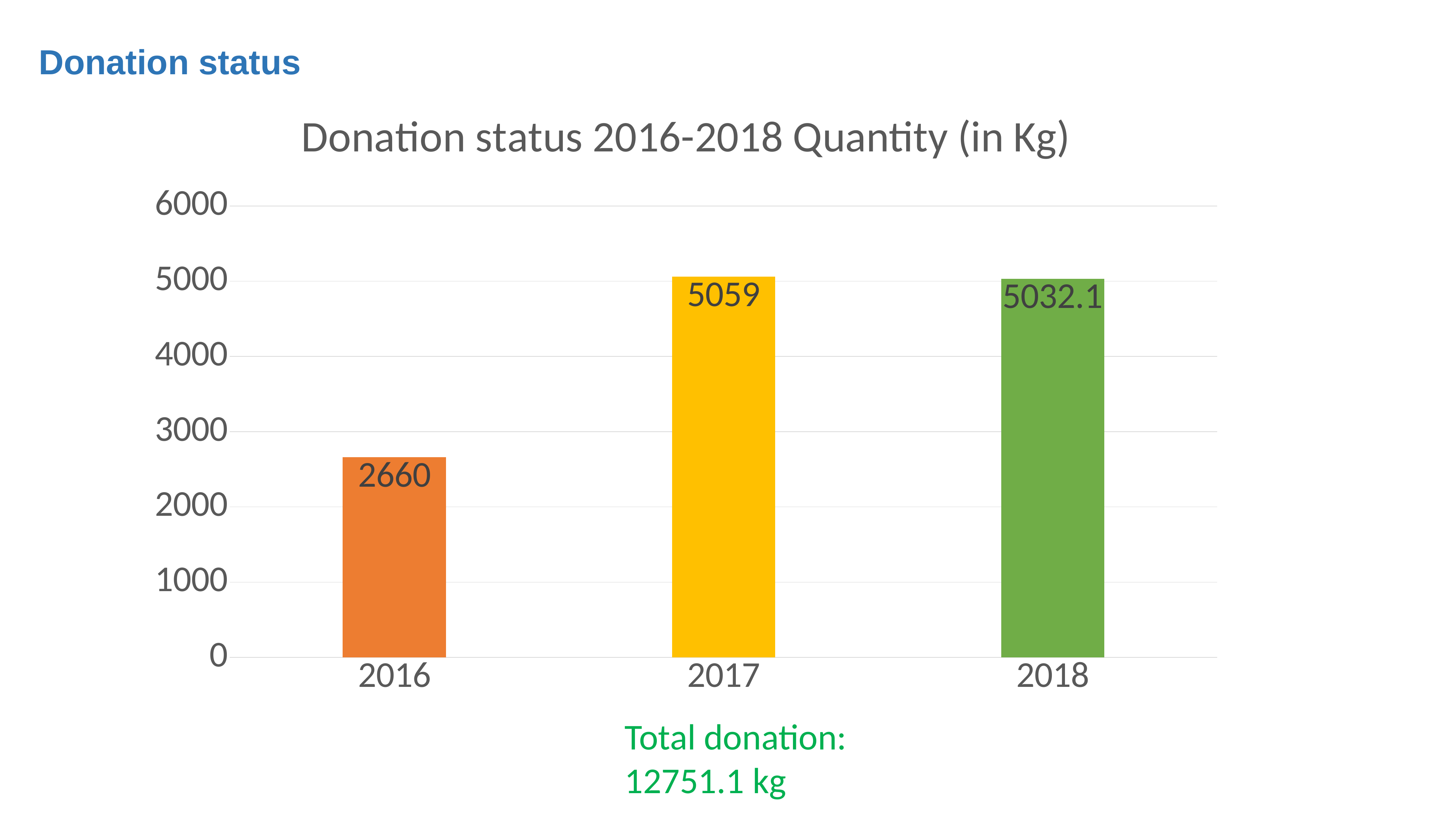
What is the difference between the donation quantities for 2017 and 2018? 26.9 What is the title of the chart? Donation status 2016-2018 Quantity (in Kg) What is the difference between the donation quantities for 2017 and 2016? 2399 What is the donation quantity for 2018? 5032.1 Which year has the highest donation quantity? 2017 Which is larger, the donation quantity for 2016 or for 2018? 2018 Which year has the lowest donation quantity? 2016 What is the donation quantity for 2017? 5059 Is the value for 2016 greater or less than 3000? less How many years are shown on the chart? 3 What kind of chart is shown on the slide? bar chart What is the donation quantity for 2016? 2660